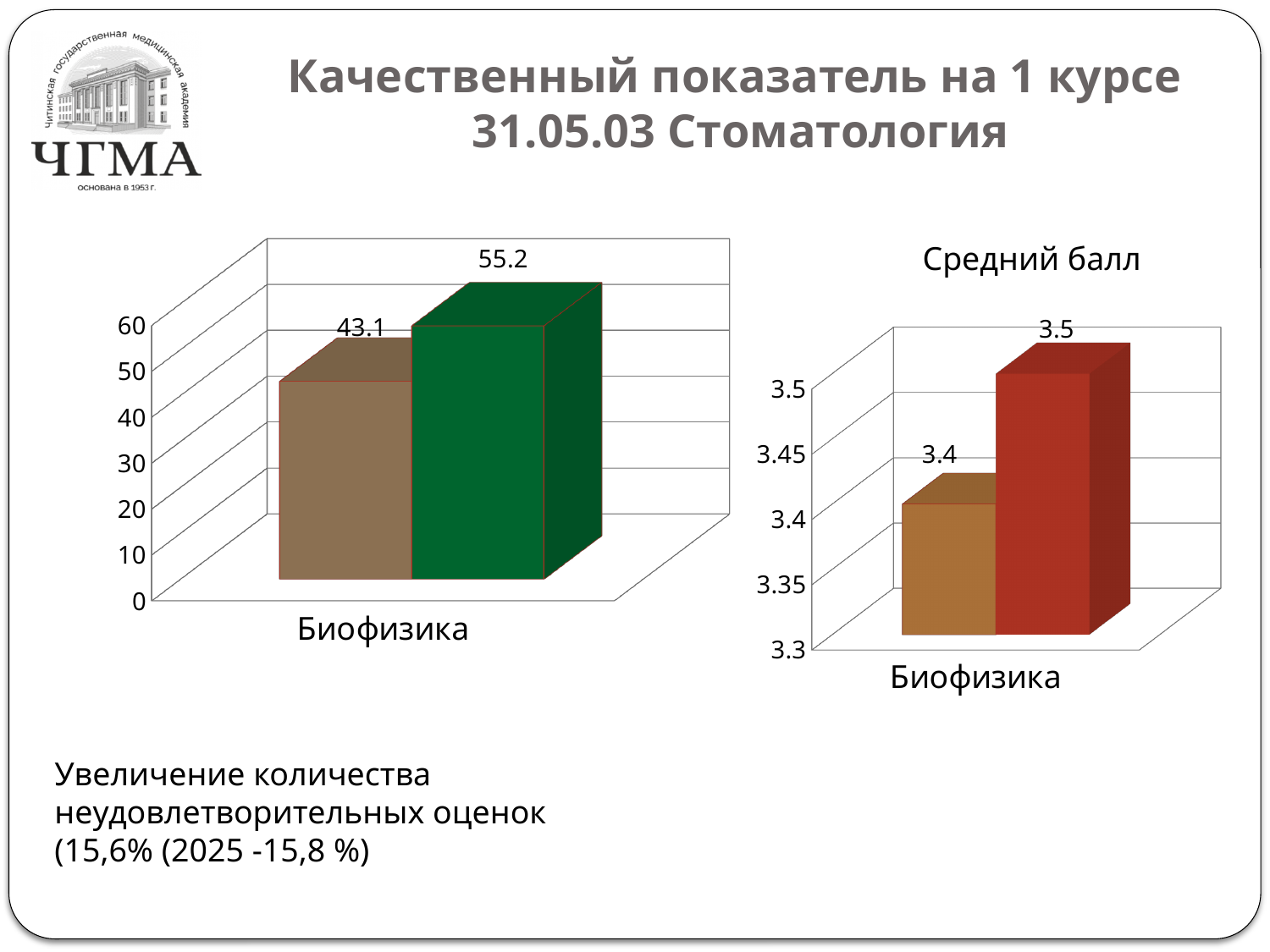
In the chart titled 'Средний балл', what is the difference between the red bar and the brown bar? 0.1 What is the title of the right chart? Средний балл In the left chart, what is the difference between the green bar (55.2) and the brown bar (43.1)? 12.1 In the chart titled 'Средний балл', what is the category label on the x axis? Биофизика What type of chart is the left chart? bar chart In the left chart, which bar is higher, the brown one or the green one? the green one In the left chart, what value is shown on the brown bar for Биофизика? 43.1 In the left chart, what value is shown on the green bar for Биофизика? 55.2 In the chart titled 'Средний балл', what value is shown on the red bar? 3.5 In the chart titled 'Средний балл', what value is shown on the brown bar? 3.4 In the left chart, how many bars are plotted? 2 In the left chart, is the value of the brown bar greater or less than 50? less